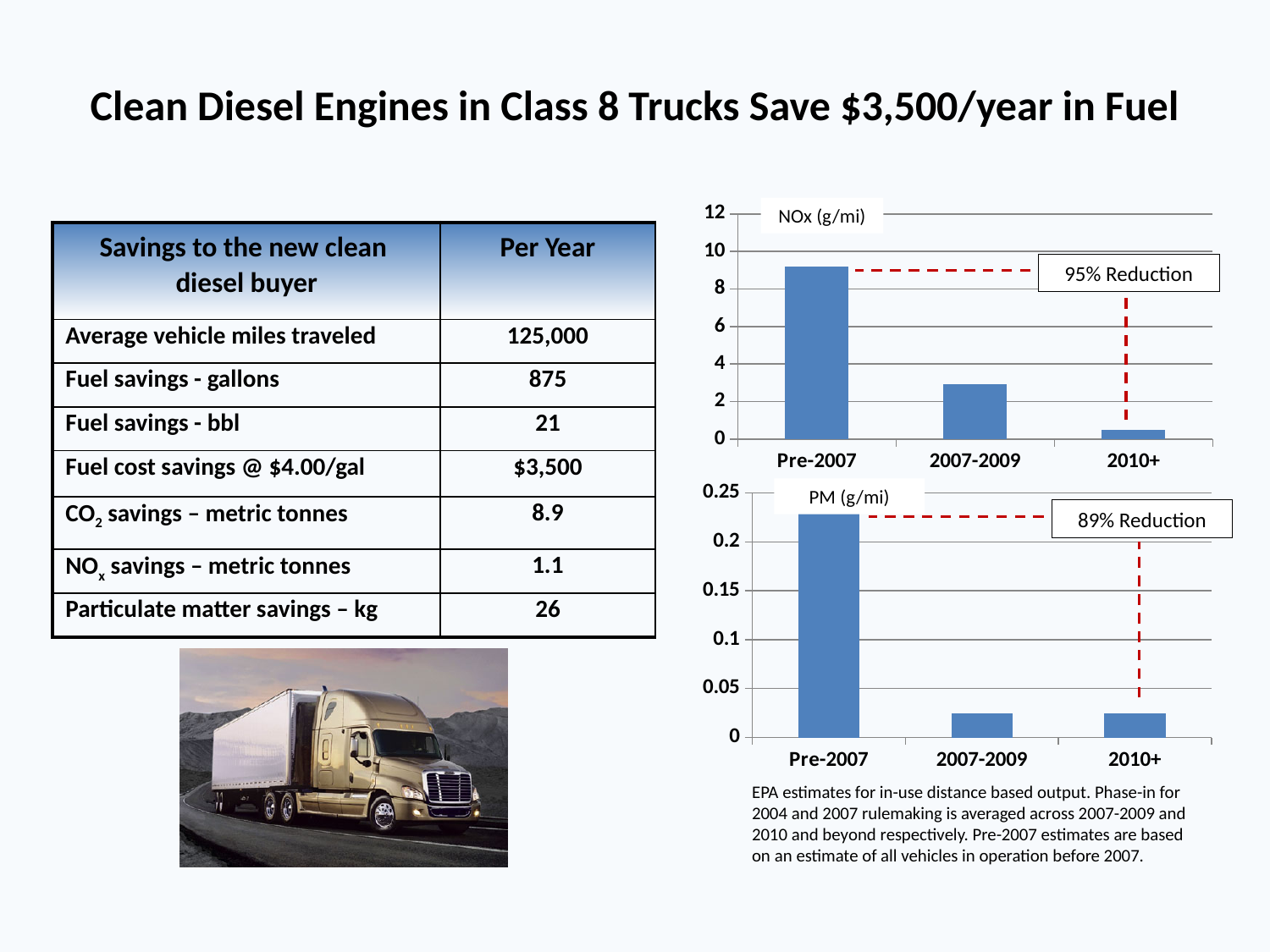
In the NOx (g/mi) chart, which category has the lowest value? 2010+ What percentage reduction is annotated on the PM (g/mi) chart? 89% Reduction How many categories are shown on the x axis of the NOx (g/mi) chart? 3 In the PM (g/mi) chart, which category has the highest value? Pre-2007 In the PM (g/mi) chart, which is larger, the value for Pre-2007 or the value for 2010+? Pre-2007 In the PM (g/mi) chart, is the value for 2007-2009 greater or less than 0.05? less In the NOx (g/mi) chart, is the value for Pre-2007 greater or less than 8? greater In the PM (g/mi) chart, is the value for Pre-2007 greater or less than 0.2? greater What kind of chart is the NOx (g/mi) chart? bar chart In the NOx (g/mi) chart, which category has the highest value? Pre-2007 In the NOx (g/mi) chart, do the values rise or fall from Pre-2007 to 2010+? fall